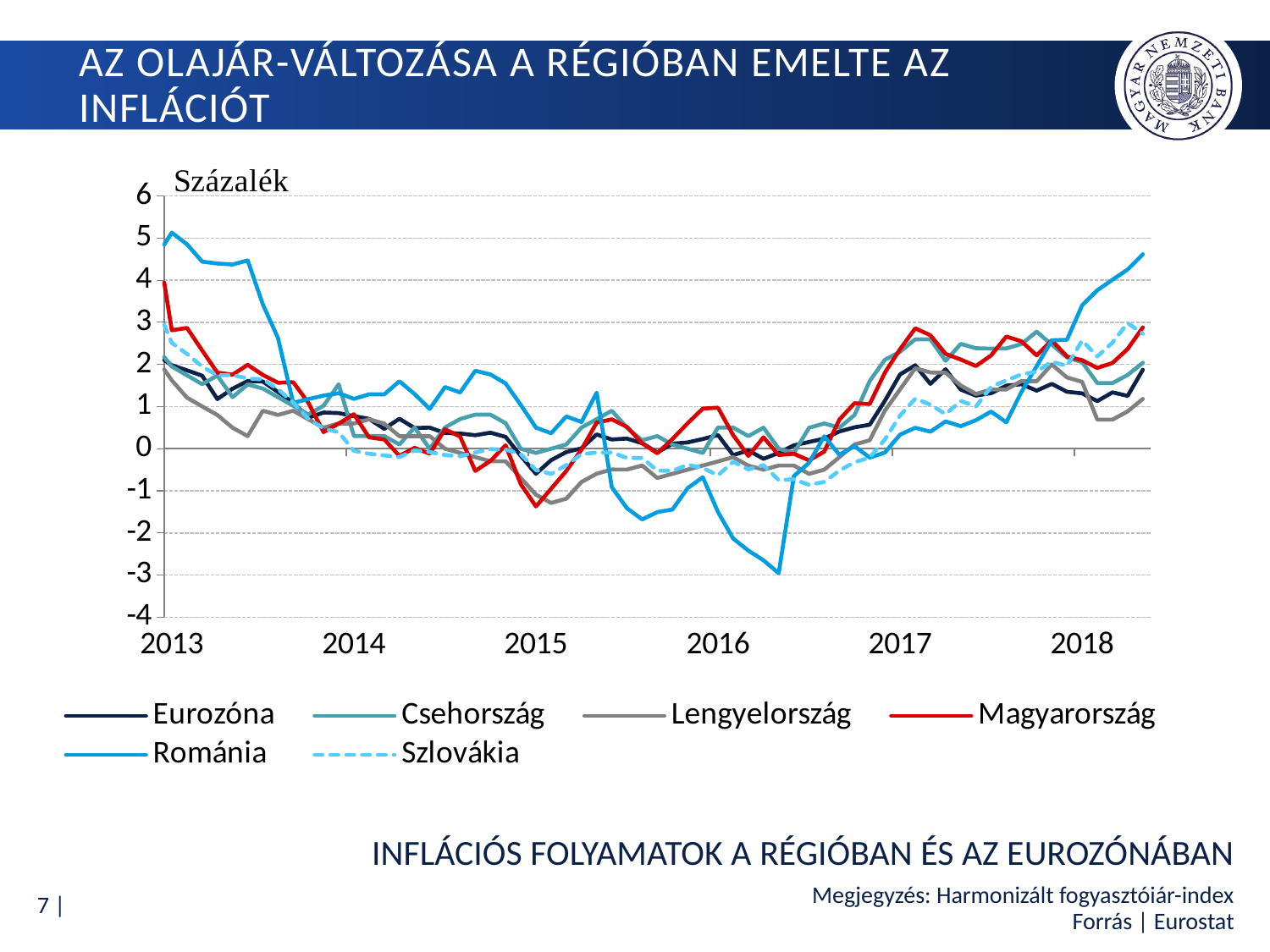
Does the Románia series rise or fall from 2017 to 2018? rise Which series reaches the highest value anywhere on the chart? Románia Which series reaches the lowest value anywhere on the chart? Románia Which series has the highest value at the end of the chart in 2018? Románia Which series has the lowest value at the end of the chart in 2018? Lengyelország Is the lowest value for Románia in 2016 greater or less than -2? less How many series does the legend list? 6 Does the Eurozóna series rise or fall from 2013 to 2015? fall Which series is drawn with a dashed line? Szlovákia Is the value for Románia at the end of the chart in 2018 greater or less than 4? greater What is the title of the chart? INFLÁCIÓS FOLYAMATOK A RÉGIÓBAN ÉS AZ EUROZÓNÁBAN What kind of chart is shown on the slide? line chart